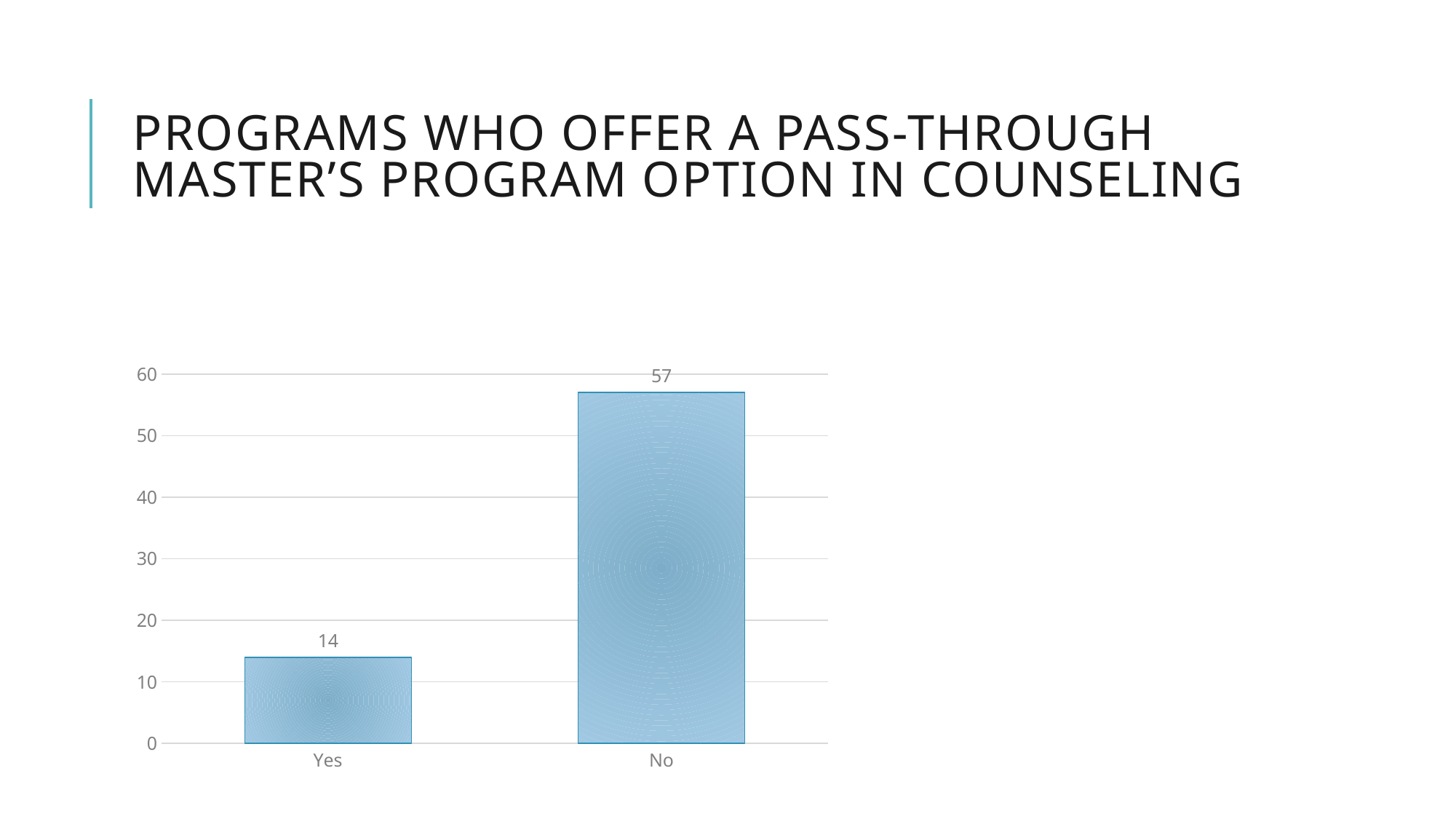
Is the value for No greater or less than 50? greater Is the value for Yes greater or less than 20? less What is the value for Yes? 14 What is the total of the two values shown in the chart? 71 What is the highest value shown on the y axis? 60 How many categories are shown on the x axis? 2 What is the difference between the values for No and Yes? 43 Which category has the lowest value? Yes What kind of chart is shown on the slide? bar chart Which category has the highest value? No What is the value for No? 57 Which is larger, the value for Yes or the value for No? No